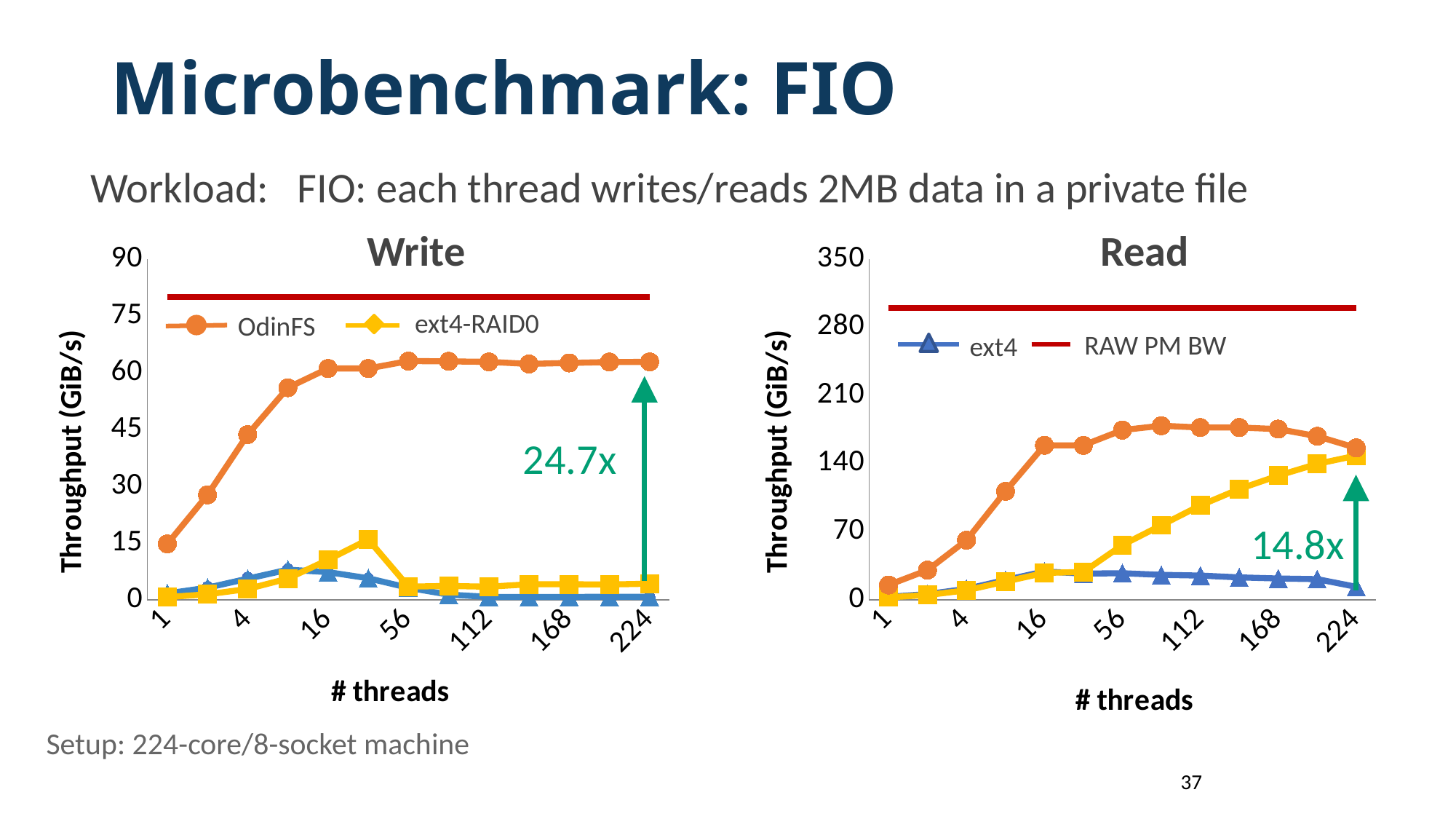
On the Read chart, is the RAW PM BW line greater or less than 280 GiB/s? greater On the Read chart, is the OdinFS throughput at 112 threads greater or less than 140 GiB/s? greater On the Read chart, is the ext4 throughput at 224 threads greater or less than 70 GiB/s? less On the Read chart, at 224 threads, which has higher throughput: ext4-RAID0 or ext4? ext4-RAID0 On the Write chart, what speedup is annotated next to the green arrow at 224 threads? 24.7x On the Write chart, which file system has the highest throughput at 224 threads? OdinFS What type of chart is the Write chart? line chart On the Read chart, what speedup is annotated next to the green arrow at 224 threads? 14.8x